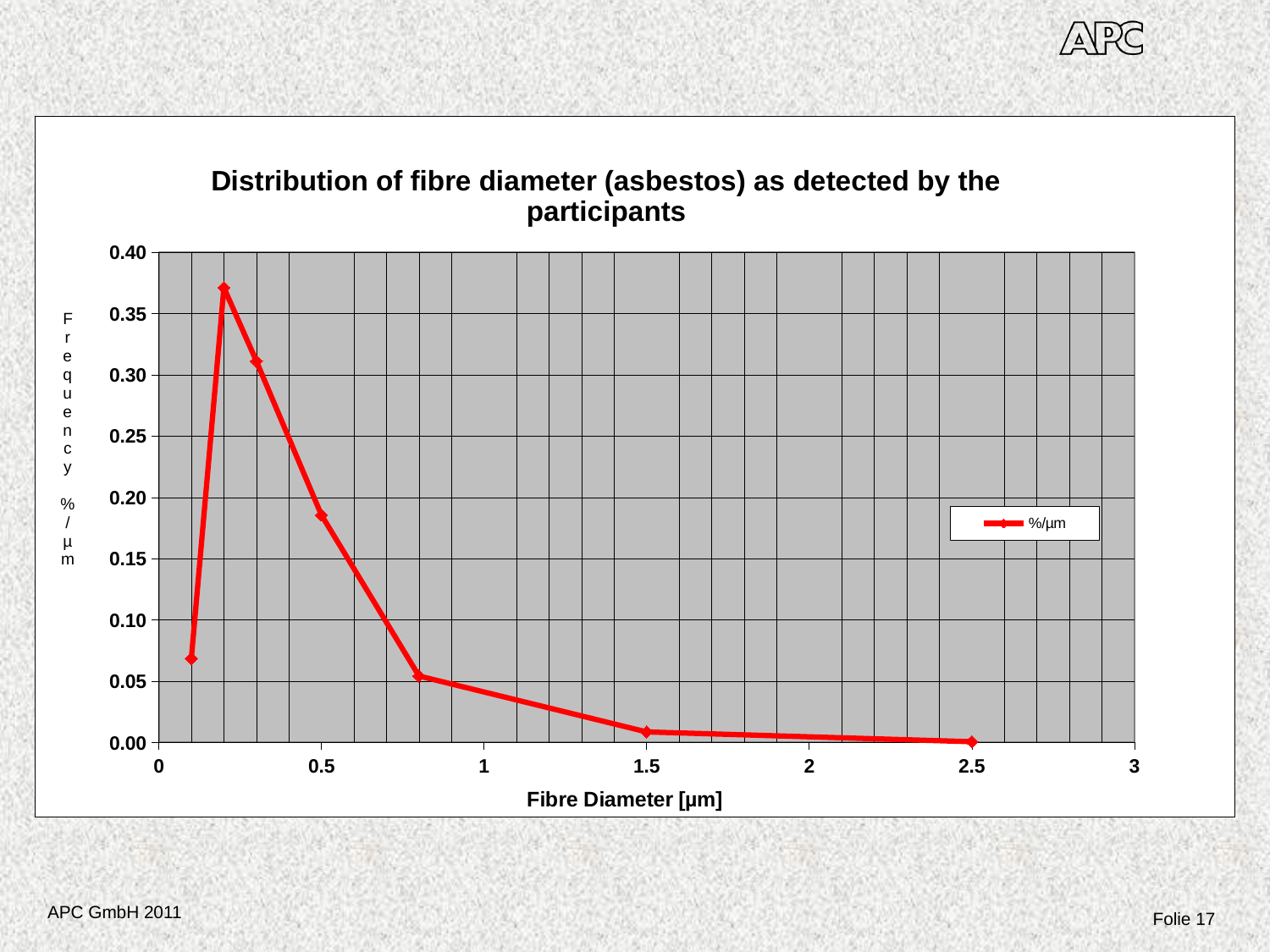
What is the legend entry for the plotted series? %/µm What is the label of the x axis? Fibre Diameter [µm] How many series does the legend list? 1 How many data points are plotted on the line? 7 Is the value at a fibre diameter of 2.5 µm greater or less than 0.05? less Is the value at a fibre diameter of 0.5 µm greater or less than 0.20? less Is the value at a fibre diameter of 1.5 µm greater or less than 0.05? less Do the values rise or fall as fibre diameter increases from 0.5 µm to 2.5 µm? fall Which is larger: the value at a fibre diameter of 0.5 µm or at 1.5 µm? 0.5 µm What kind of chart is shown on the slide? line chart